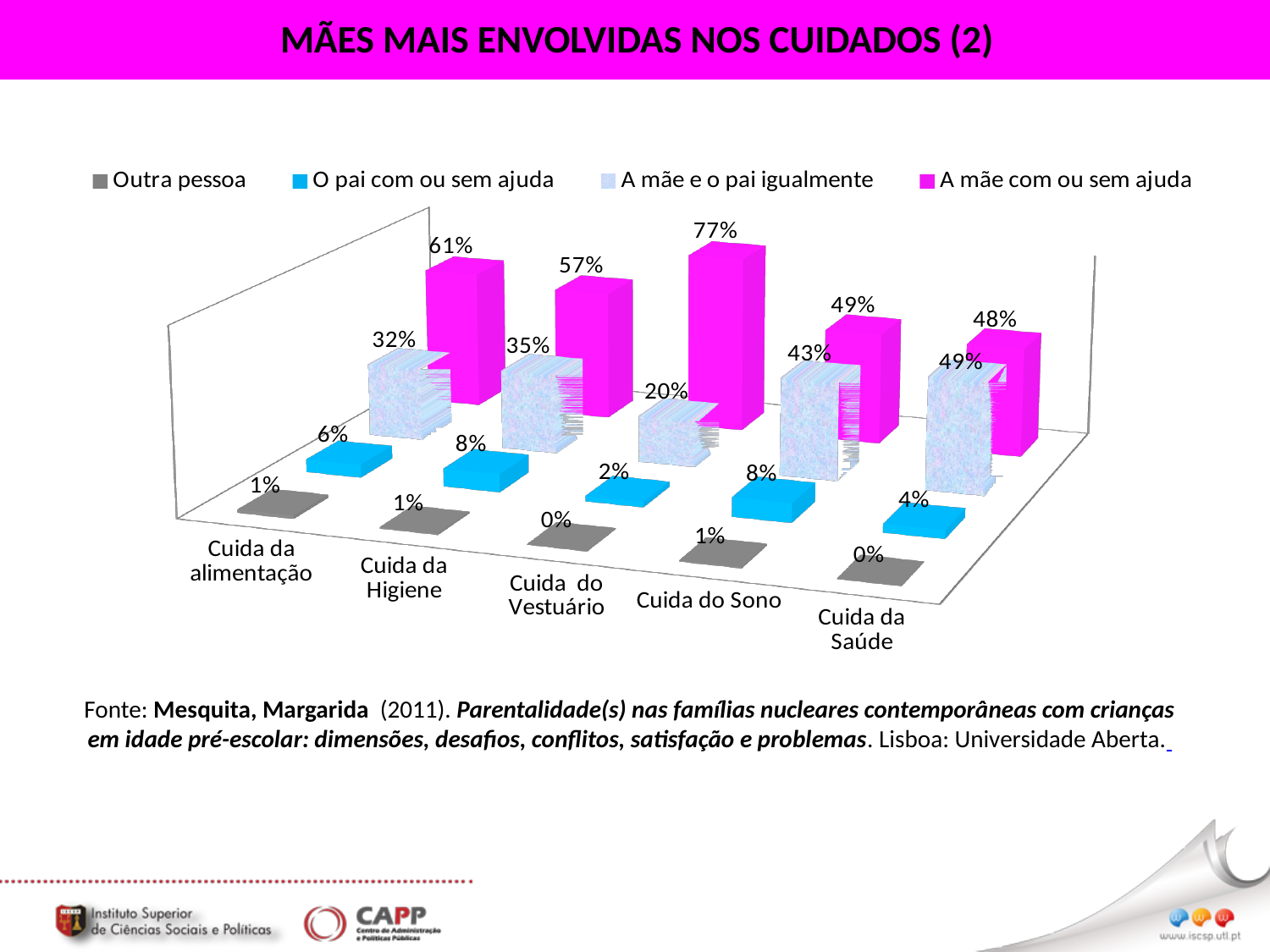
Which legend entry is shown in magenta? A mãe com ou sem ajuda What is the value for "A mãe e o pai igualmente" in the "Cuida da Higiene" category? 35% In which category does "A mãe e o pai igualmente" have its lowest value? Cuida do Vestuário Which is larger in the "Cuida do Sono" category: "A mãe com ou sem ajuda" or "A mãe e o pai igualmente"? A mãe com ou sem ajuda What is the value for "Outra pessoa" in the "Cuida da Saúde" category? 0% How many categories are shown on the x axis of the chart? 5 What kind of chart is shown on the slide? Bar chart What is the value for "O pai com ou sem ajuda" in the "Cuida da alimentação" category? 6% How many series does the legend list? 4 In which category does "A mãe com ou sem ajuda" reach its highest value? Cuida do Vestuário What is the difference between "A mãe com ou sem ajuda" and "A mãe e o pai igualmente" in the "Cuida da alimentação" category? 29% What is the value for "A mãe com ou sem ajuda" in the "Cuida do Sono" category? 49%